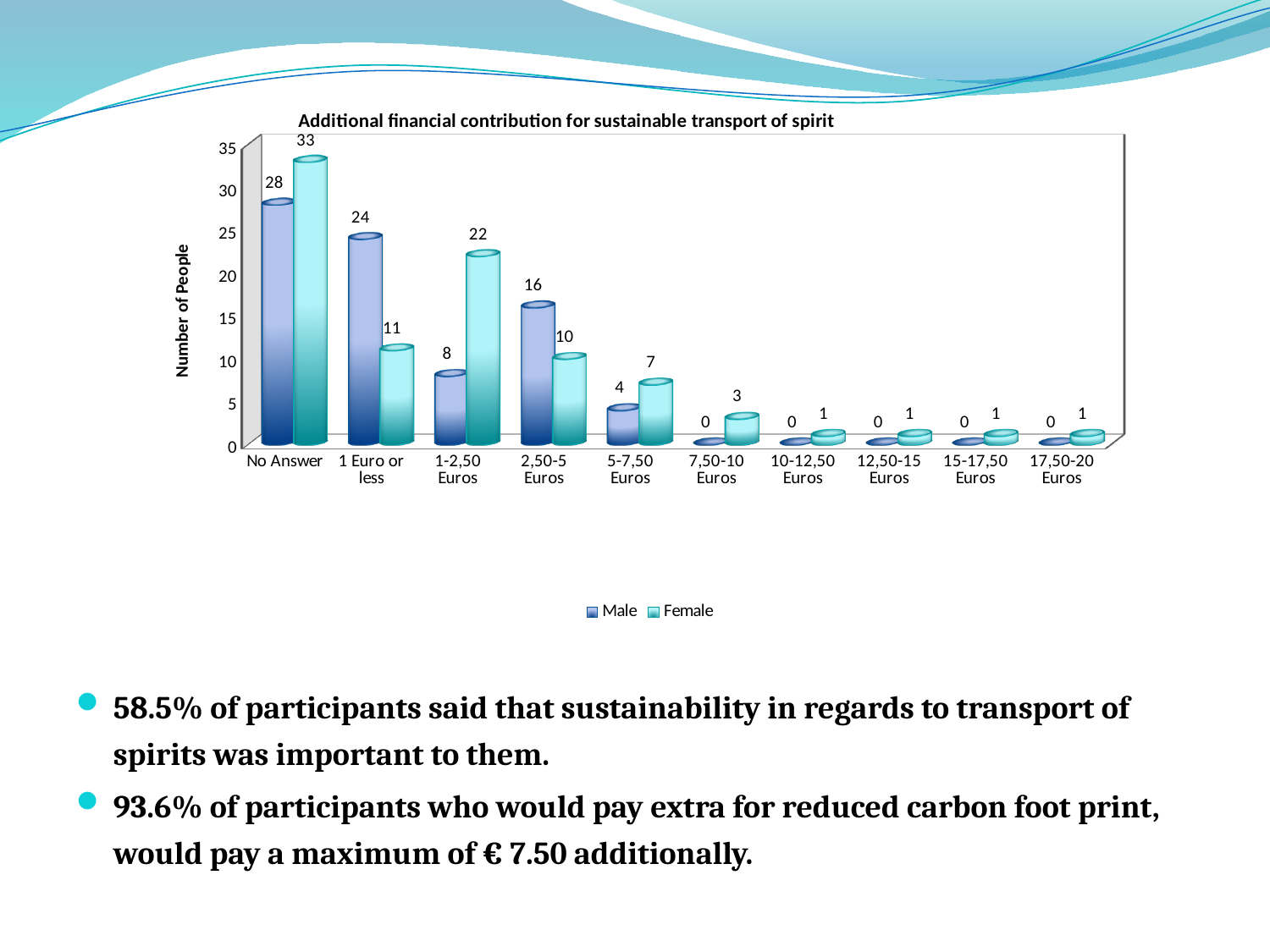
What is the difference between the Female and Male values for the 1 Euro or less category? 13 Do the Male values rise or fall from No Answer to 17,50-20 Euros? Fall Which category has the highest Male value? No Answer What is the Male value for the 1 Euro or less category? 24 Which is larger for the 2,50-5 Euros category, the Male value or the Female value? Male What is the label of the vertical axis? Number of People What is the title of the chart? Additional financial contribution for sustainable transport of spirit How many categories are shown on the x axis? 10 What is the Female value for the 1-2,50 Euros category? 22 How many series does the legend list? 2 Which category has the highest Female value? No Answer What kind of chart is shown on the slide? Bar chart